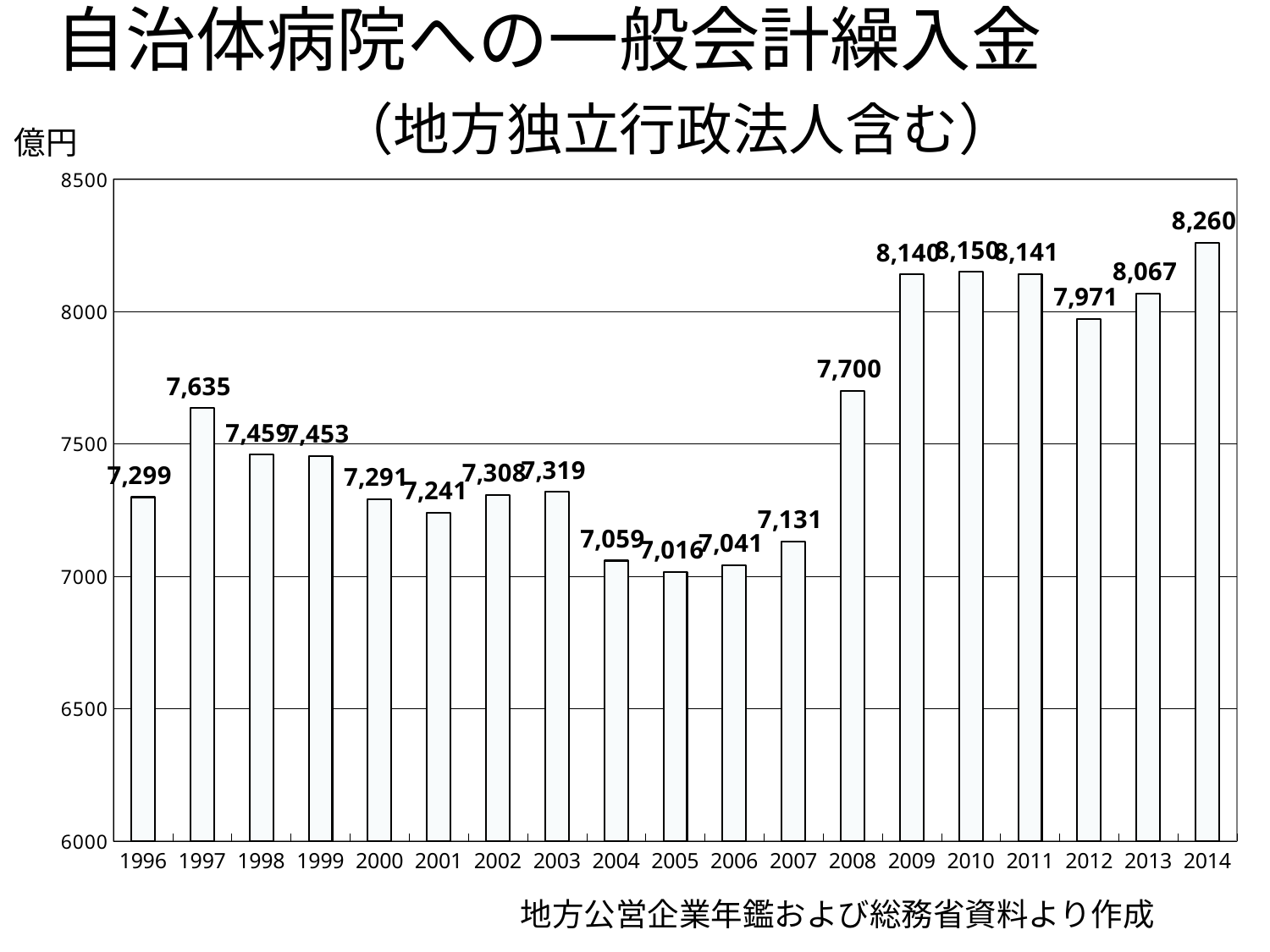
Is the value for 2008 greater or less than 7500? greater What kind of chart is shown on the slide? bar chart What is the value for 2014? 8,260 What is the value for 2012? 7,971 What is the difference between the values for 2014 and 2013? 193 Which year has the lowest value? 2005 What is the value for 2008? 7,700 Which year has the highest value? 2014 Which is larger, the value for 1997 or the value for 1998? 1997 How many years are shown on the x axis? 19 What unit is shown at the top left of the chart's y axis? 億円 What is the value for 1997? 7,635